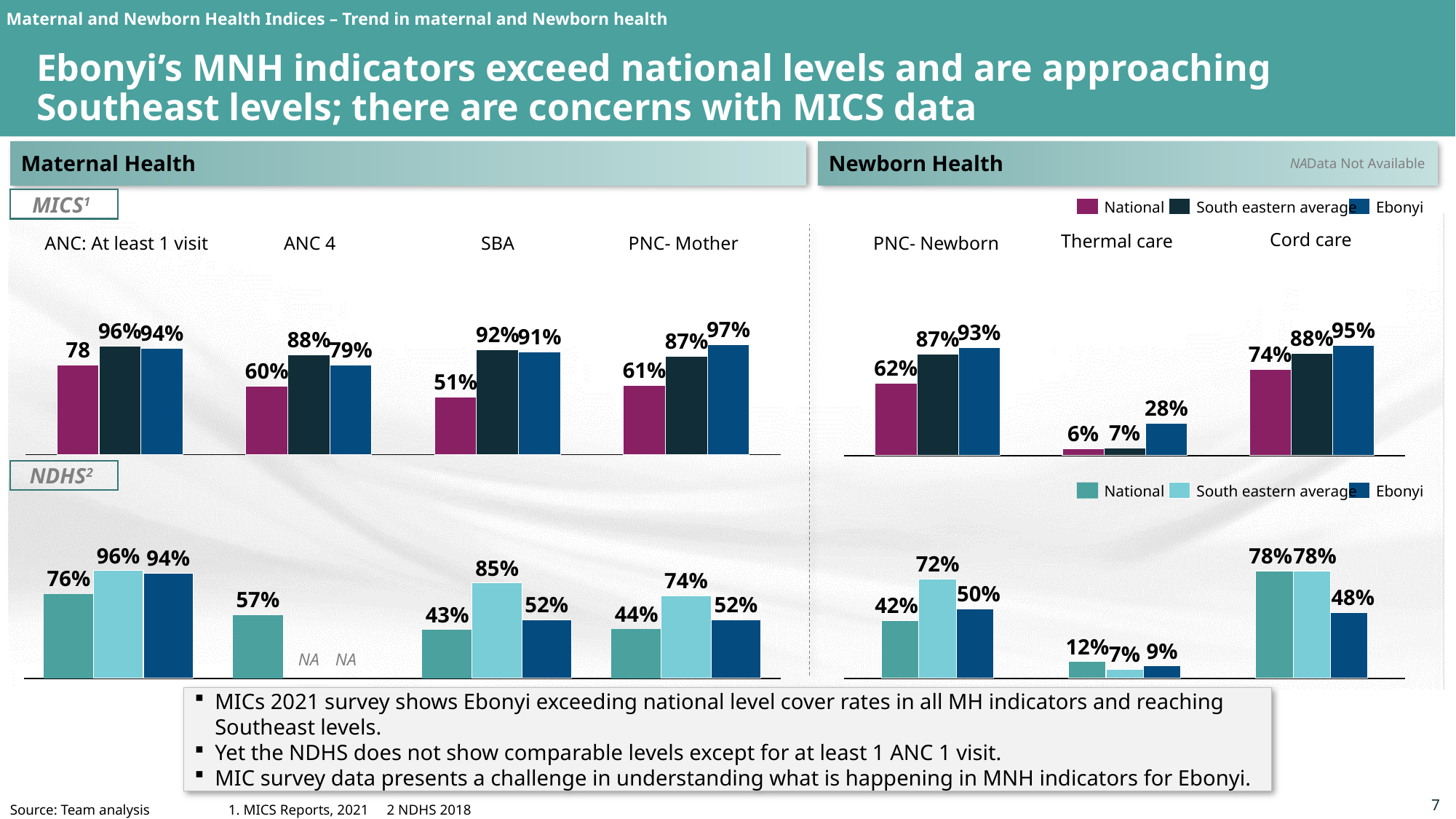
In the MICS Maternal Health chart, which indicator has the lowest National value? SBA What type of chart is used for the NDHS Maternal Health data? Bar chart In the MICS Newborn Health chart, which indicator has the highest Ebonyi value? Cord care In the NDHS Maternal Health chart, what is the South eastern average value for SBA? 85% In the MICS Maternal Health chart, what is the Ebonyi value for PNC- Mother? 97% In the MICS Maternal Health chart, what is the difference between the South eastern average and National values for ANC 4? 28% In the NDHS Newborn Health chart, what is the Ebonyi value for Cord care? 48% In the NDHS Newborn Health chart, what is the difference between the South eastern average and Ebonyi values for PNC- Newborn? 22% In the NDHS Maternal Health chart, which indicator shows NA for the South eastern average and Ebonyi values? ANC 4 In the MICS Newborn Health chart, what is the National value for Thermal care? 6% How many series does the legend of the MICS Newborn Health chart list? 3 In the NDHS Maternal Health chart, which is larger for PNC- Mother: the National value or the Ebonyi value? Ebonyi